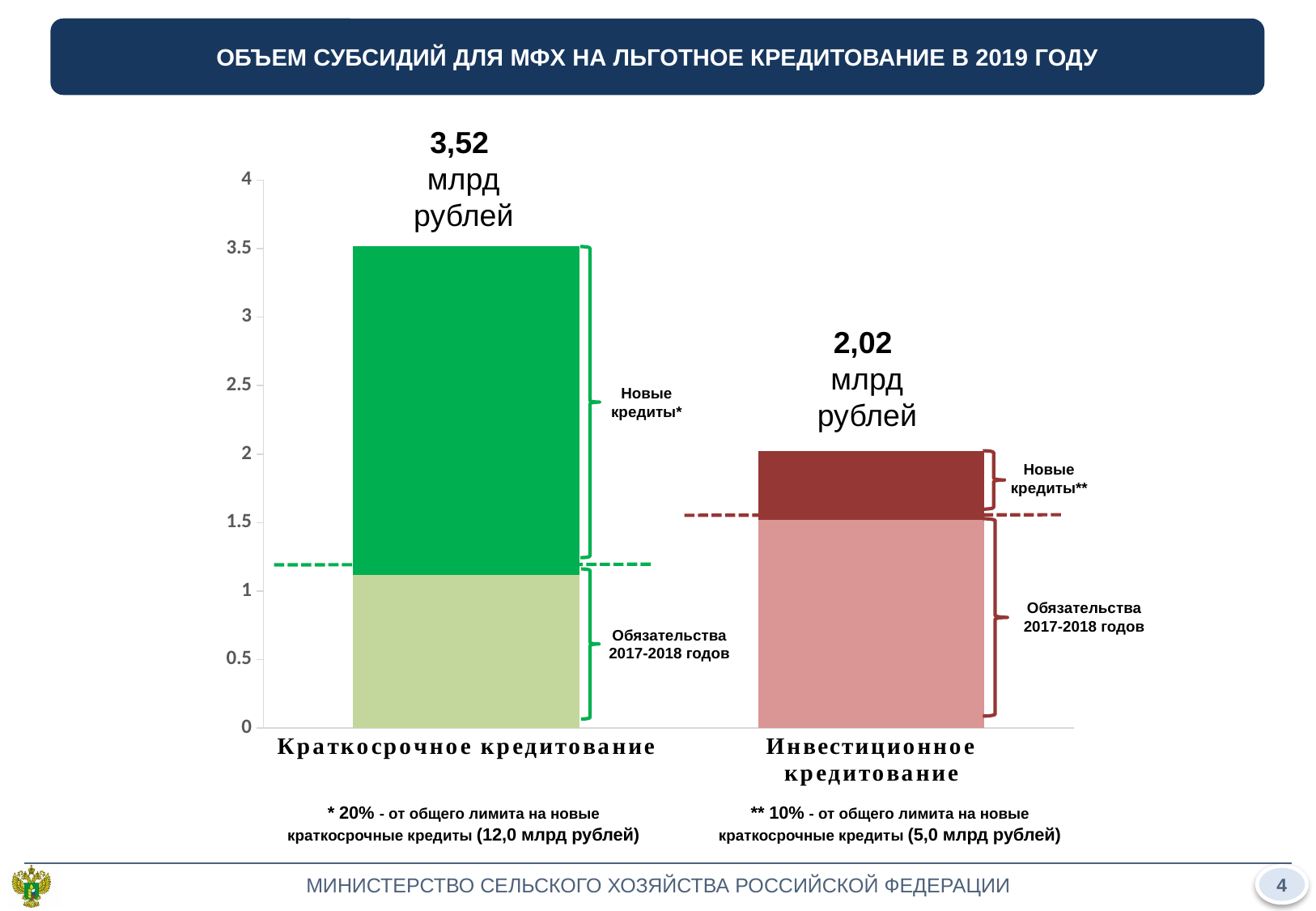
What is the title of the slide? ОБЪЕМ СУБСИДИЙ ДЛЯ МФХ НА ЛЬГОТНОЕ КРЕДИТОВАНИЕ В 2019 ГОДУ What kind of chart is shown on the slide? Stacked bar chart Which category has the lower total subsidy volume? Инвестиционное кредитование Which category has the higher total subsidy volume? Краткосрочное кредитование What is the total value shown for Инвестиционное кредитование? 2,02 млрд рублей What is the total value shown for Краткосрочное кредитование? 3,52 млрд рублей Is the Обязательства 2017-2018 годов segment for Краткосрочное кредитование greater or less than 1.5? less What is the difference between the totals for Краткосрочное кредитование and Инвестиционное кредитование? 1,50 млрд рублей Is the Обязательства 2017-2018 годов segment for Инвестиционное кредитование greater or less than 1? greater How many segments does each stacked bar consist of? 2 Is the total for Краткосрочное кредитование larger or smaller than the total for Инвестиционное кредитование? larger How many categories are shown on the x axis of the chart? 2